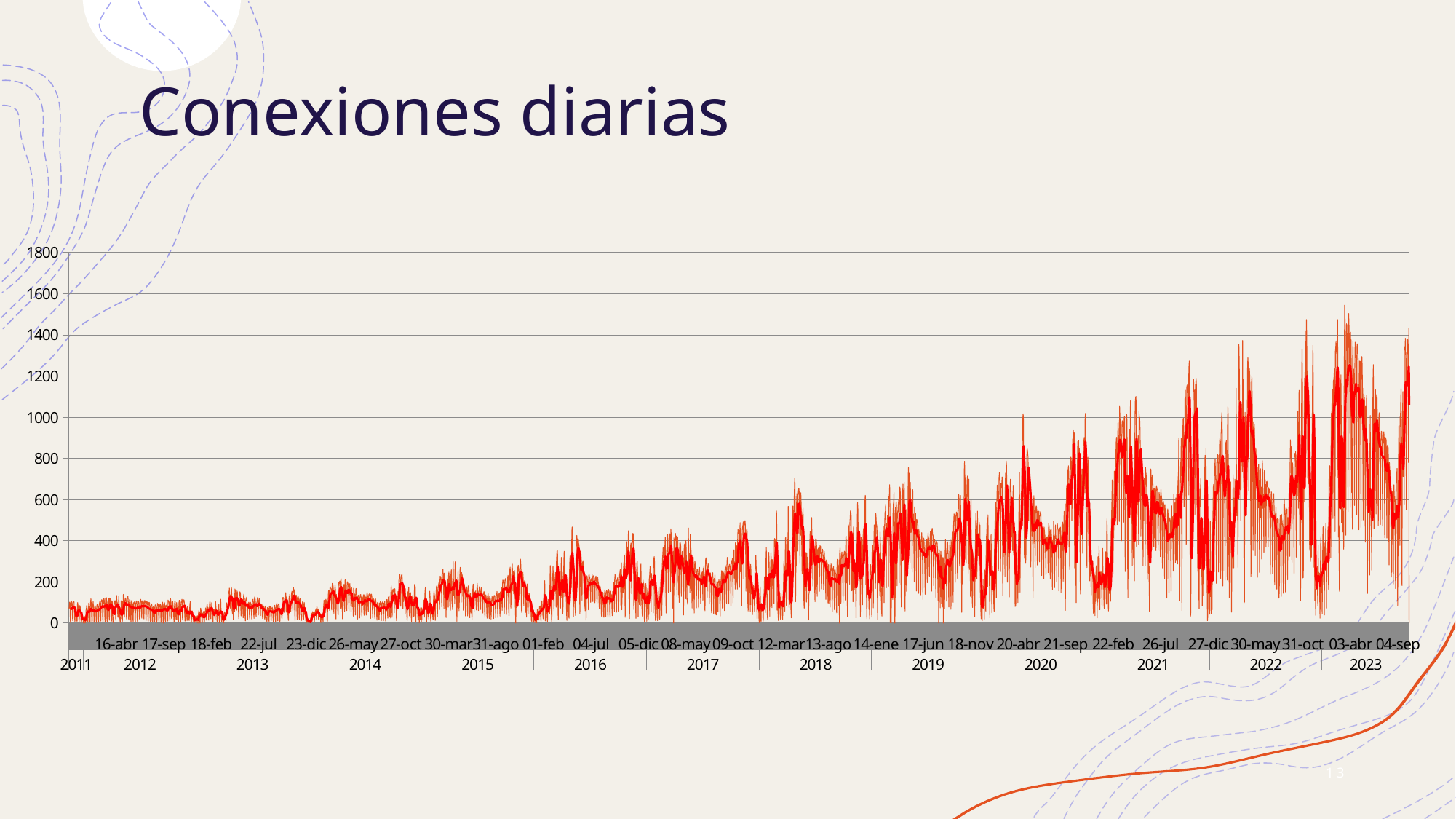
Are the daily connection values in 2011 greater or less than 400? less Is the highest peak in 2023 greater or less than 1400? greater What kind of chart is shown on the slide? line chart Are the daily connection values in 2012 greater or less than 200? less How many year labels are shown along the x axis? 13 What is the title of the chart? Conexiones diarias Overall, do the daily connection values rise or fall from 2011 to 2023? rise Which year shows the highest daily connection values? 2023 Which year shows the lowest daily connection values? 2011 What is the highest value shown on the y axis? 1800 Are the values in 2022 generally larger or smaller than the values in 2014? larger